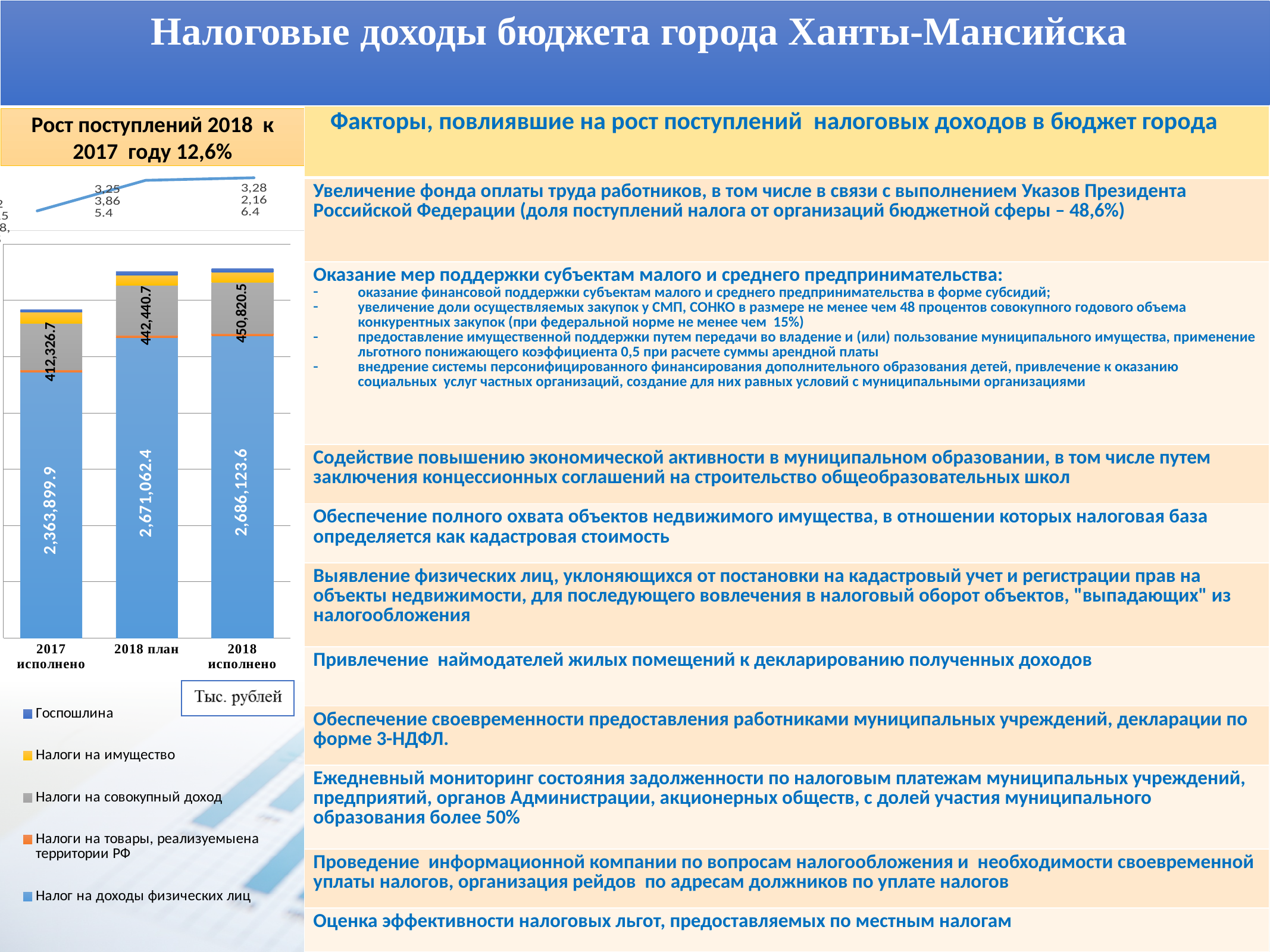
How many categories are shown on the x axis of the bar chart? 3 What is the value of Налог на доходы физических лиц for 2018 исполнено? 2,686,123.6 What is the difference in Налог на доходы физических лиц between 2018 исполнено and 2017 исполнено? 322,223.7 What is the value of Налоги на совокупный доход for 2018 план? 442,440.7 How many series does the legend of the bar chart list? 5 Which category has the highest value for Налог на доходы физических лиц? 2018 исполнено What unit of measurement is indicated for the bar chart? Тыс. рублей What is the value of Налоги на совокупный доход for 2018 исполнено? 450,820.5 What is the value of Налог на доходы физических лиц for 2017 исполнено? 2,363,899.9 Which is larger for Налоги на совокупный доход: 2018 план or 2018 исполнено? 2018 исполнено What is the value of Налог на доходы физических лиц for 2018 план? 2,671,062.4 Which category has the lowest value for Налоги на совокупный доход? 2017 исполнено